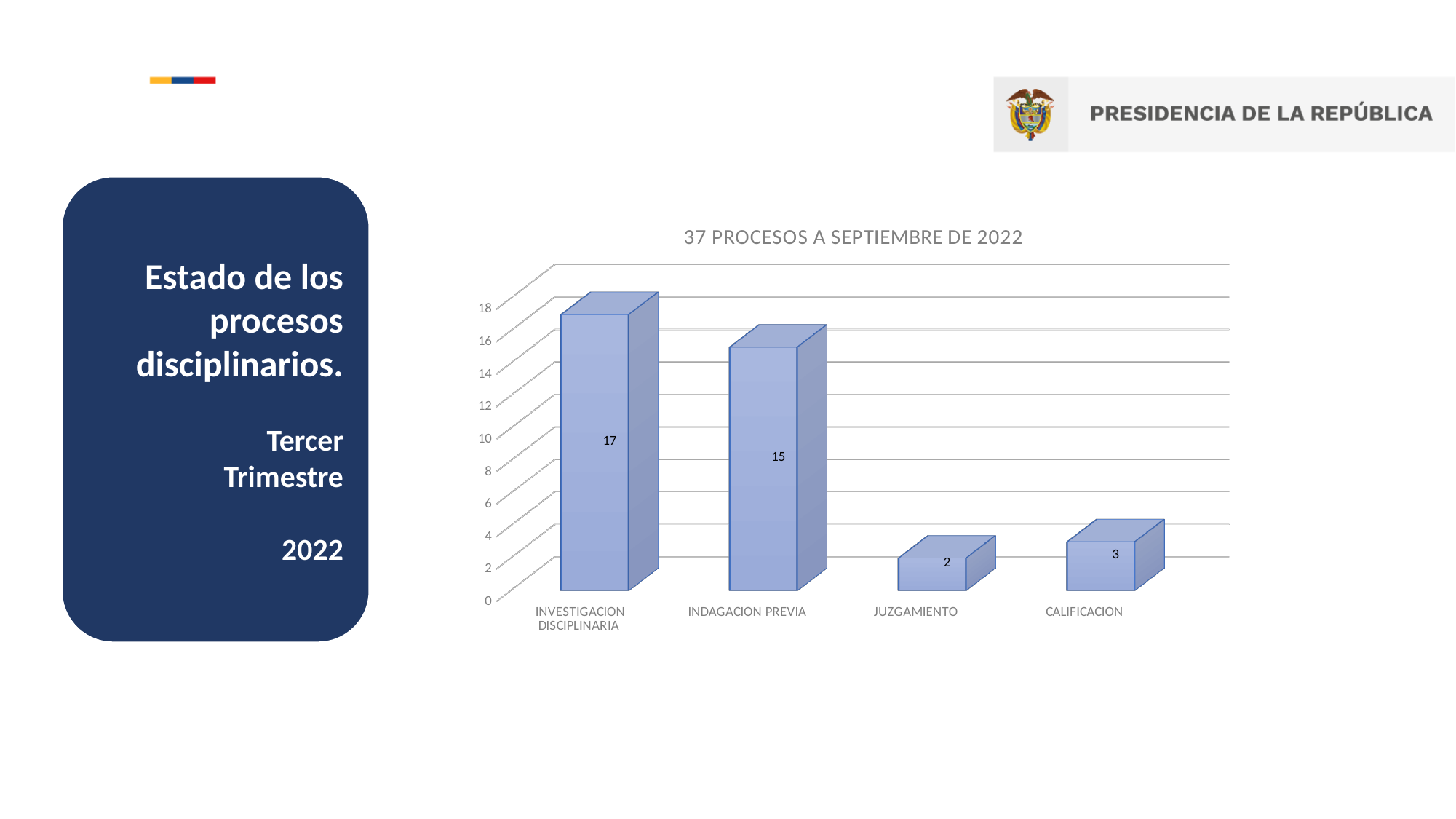
What is the value for CALIFICACION? 3 What is the value for INVESTIGACION DISCIPLINARIA? 17 Which category has the lowest value? JUZGAMIENTO What is the value for JUZGAMIENTO? 2 Is the value for INDAGACION PREVIA greater or less than 10? greater How many categories are shown on the chart? 4 Which category has the highest value? INVESTIGACION DISCIPLINARIA What is the value for INDAGACION PREVIA? 15 What is the title of the chart? 37 PROCESOS A SEPTIEMBRE DE 2022 Which is larger, the value for CALIFICACION or the value for JUZGAMIENTO? CALIFICACION What is the difference between the values for INVESTIGACION DISCIPLINARIA and INDAGACION PREVIA? 2 What kind of chart is shown on the slide? bar chart